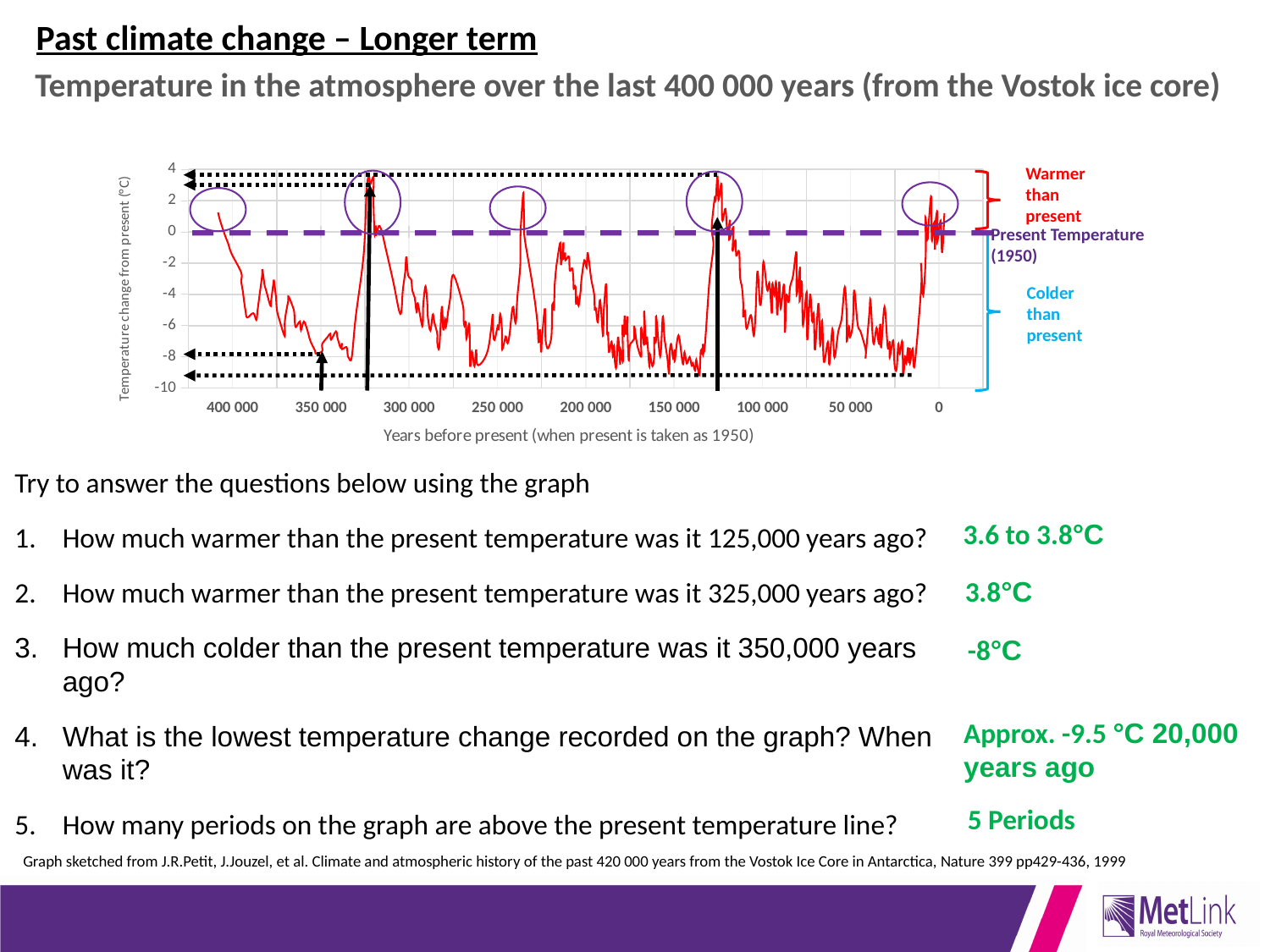
Which was warmer, 125,000 years ago or 20,000 years ago? 125,000 years ago Is the temperature change 50,000 years ago greater or less than 0? less What is the title of the x axis of the chart? Years before present (when present is taken as 1950) What kind of chart is shown on the slide? line chart Is the temperature change 125,000 years ago greater or less than 2? greater Does the temperature change rise or fall between 350,000 years ago and 325,000 years ago? rise Which was warmer, 325,000 years ago or 350,000 years ago? 325,000 years ago Is the temperature change 20,000 years ago greater or less than -8? less How many periods on the graph are circled as being above the present temperature line? 5 What does the purple dashed horizontal line on the chart represent? Present Temperature (1950)